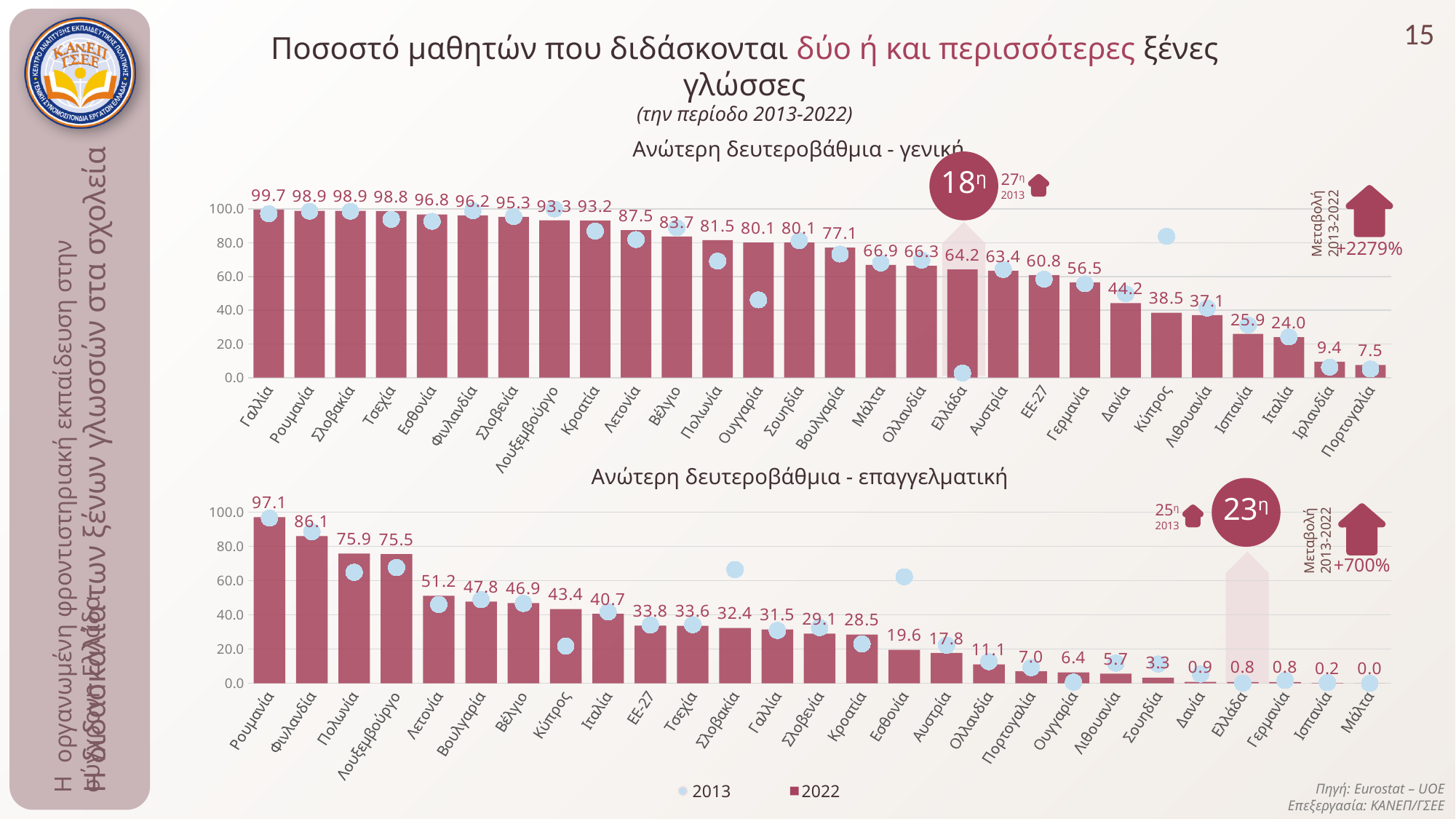
In the chart 'Ανώτερη δευτεροβάθμια - επαγγελματική', what is the 2022 value for ΕΕ-27? 33.8 In the chart 'Ανώτερη δευτεροβάθμια - γενική', which country has the lowest 2022 value? Πορτογαλία How many countries/categories are shown in the chart 'Ανώτερη δευτεροβάθμια - επαγγελματική'? 27 In the chart 'Ανώτερη δευτεροβάθμια - γενική', which country has the highest 2022 value? Γαλλία In the chart 'Ανώτερη δευτεροβάθμια - γενική', what is the difference between the 2022 values for Ελλάδα and ΕΕ-27? 3.4 In the chart 'Ανώτερη δευτεροβάθμια - γενική', is the 2013 value for Ελλάδα greater or less than 20? less In the chart 'Ανώτερη δευτεροβάθμια - γενική', what is the 2022 value for Ελλάδα? 64.2 In the chart 'Ανώτερη δευτεροβάθμια - επαγγελματική', is the 2013 value for Σλοβακία greater or less than 60? greater In the chart 'Ανώτερη δευτεροβάθμια - επαγγελματική', which has the larger 2022 value, Λετονία or Βουλγαρία? Λετονία In the chart 'Ανώτερη δευτεροβάθμια - επαγγελματική', which country has the highest 2022 value? Ρουμανία How many series does the legend list? 2 What kind of chart is 'Ανώτερη δευτεροβάθμια - γενική'? bar chart